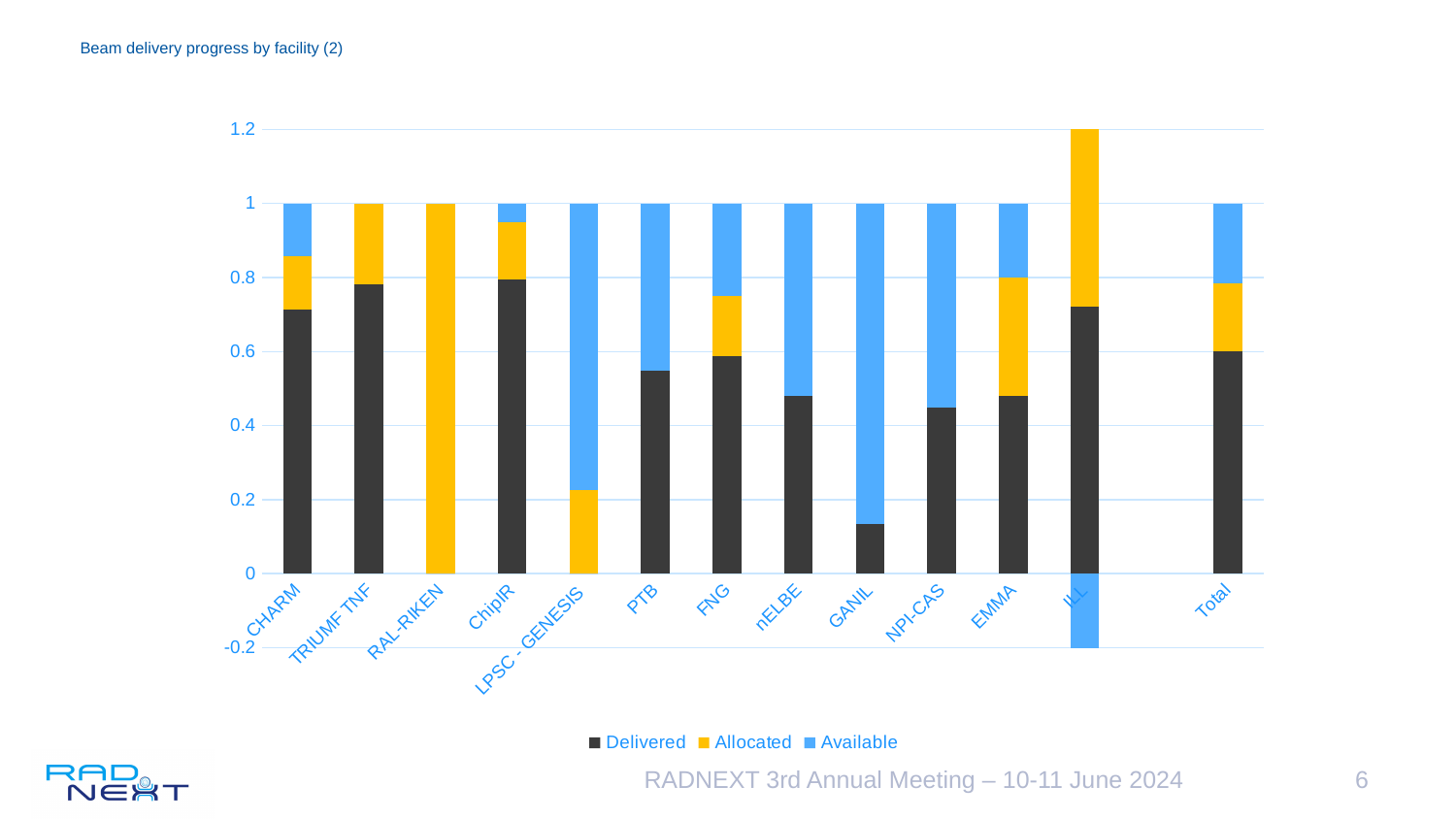
What kind of chart is shown on the slide? Stacked bar chart What is the title of the chart? Beam delivery progress by facility (2) Is the Delivered value for PTB greater or less than 0.4? greater Which has the larger Delivered value, TRIUMF TNF or PTB? TRIUMF TNF Is the Delivered value for GANIL greater or less than 0.2? less Which has the larger Delivered value, CHARM or GANIL? CHARM Which facility's bar extends below zero on the chart? ILL Which facility's bar consists entirely of the Allocated series? RAL-RIKEN How many categories are shown along the x axis of the chart? 13 How many series does the chart legend list? 3 Is the Delivered value for ChipIR greater or less than 0.6? greater